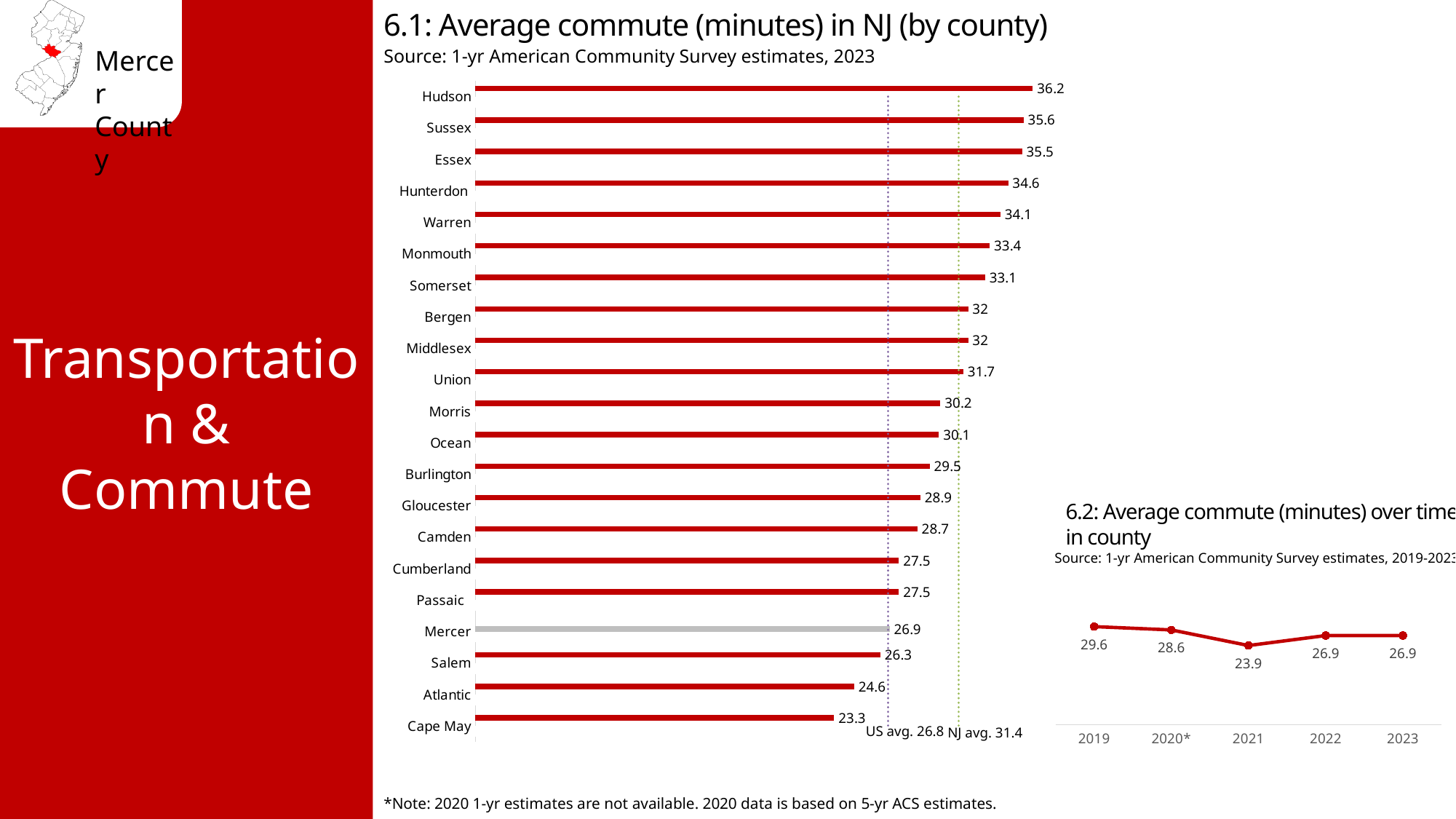
In chart 6.1 (Average commute in NJ by county), which has a larger value, Morris or Burlington? Morris In chart 6.1 (Average commute in NJ by county), which county has the highest average commute? Hudson In chart 6.1 (Average commute in NJ by county), which county has the lowest average commute? Cape May In chart 6.1 (Average commute in NJ by county), what is the difference between the values for Hudson and Cape May? 12.9 In chart 6.1, what NJ average commute value is marked by the dotted reference line? 31.4 In chart 6.2 (Average commute over time in county), what is the value for 2021? 23.9 In chart 6.2 (Average commute over time in county), how many years are plotted? 5 In chart 6.1 (Average commute in NJ by county), how many counties are shown? 21 What kind of chart is chart 6.1 (Average commute in NJ by county)? Bar chart In chart 6.1 (Average commute in NJ by county), what is the average commute for Hudson? 36.2 In chart 6.2 (Average commute over time in county), which year has the highest value? 2019 In chart 6.1 (Average commute in NJ by county), what is the average commute for Mercer? 26.9